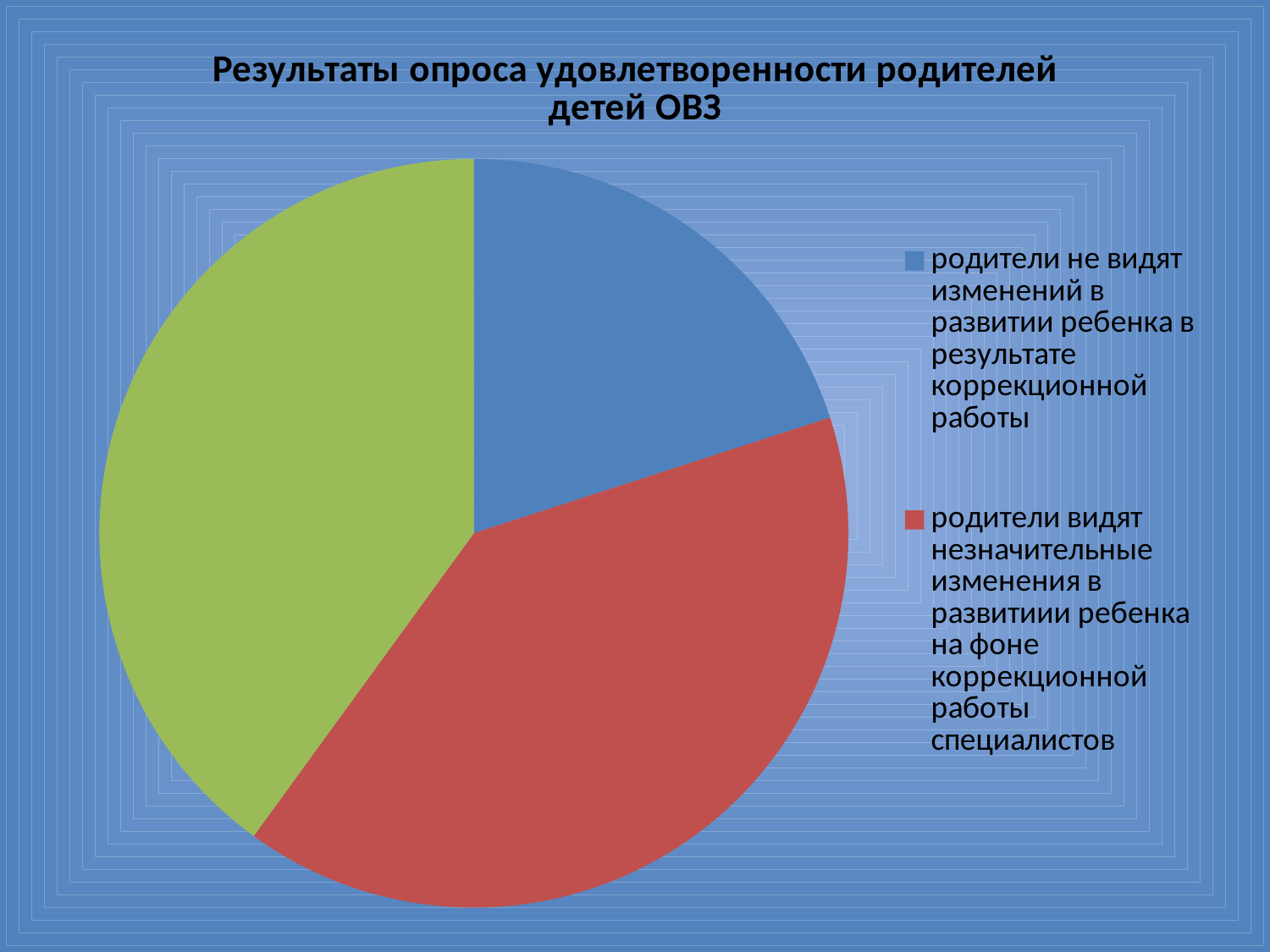
What is the title of the chart? Результаты опроса удовлетворенности родителей детей ОВЗ What colour is the slice for 'родители видят незначительные изменения в развитиии ребенка на фоне коррекционной работы специалистов'? red Which legend category has the smallest slice of the pie? родители не видят изменений в развитии ребенка в результате коррекционной работы Which slice is larger: the blue slice or the red slice? the red slice What kind of chart is shown on the slide? pie chart How many entries does the legend list? 2 Is the blue slice smaller than the green slice? yes How many slices does the pie chart have? 3 Which is larger: the slice for 'родители не видят изменений в развитии ребенка в результате коррекционной работы' or the slice for 'родители видят незначительные изменения в развитиии ребенка на фоне коррекционной работы специалистов'? родители видят незначительные изменения в развитиии ребенка на фоне коррекционной работы специалистов